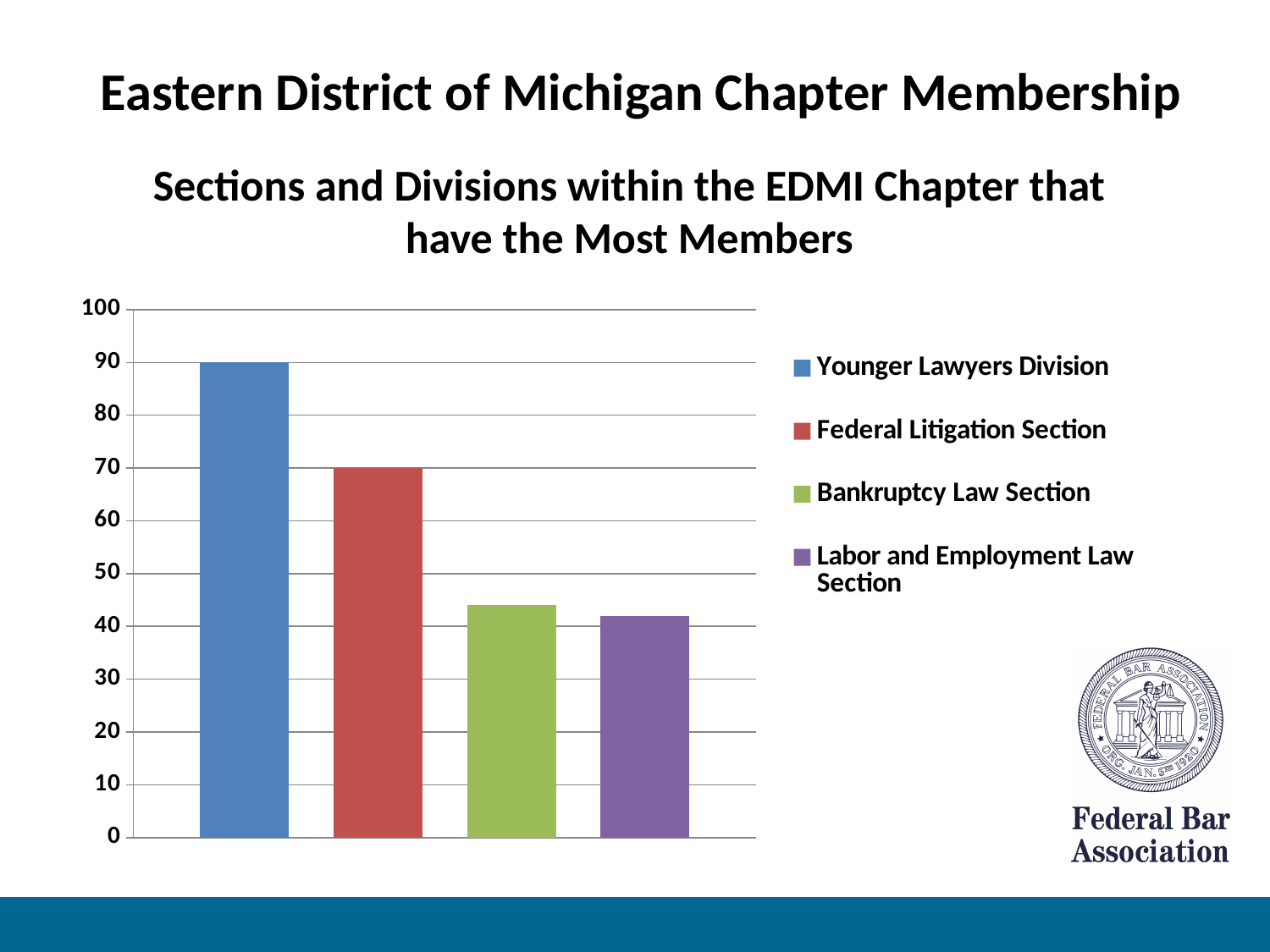
What is the value for the Federal Litigation Section? 70 What type of chart is shown on the slide? Bar chart Is the value for the Labor and Employment Law Section greater or less than 40? greater What colour is the bar for the Bankruptcy Law Section? Green How many bars are plotted in the chart? 4 What is the value for the Younger Lawyers Division? 90 Do the bar values rise or fall from left to right across the chart? fall Which is larger, the value for the Younger Lawyers Division or the Federal Litigation Section? Younger Lawyers Division Which section or division has the highest value? Younger Lawyers Division Is the value for the Bankruptcy Law Section greater or less than 50? less How many series does the legend list? 4 What is the difference between the Younger Lawyers Division and the Federal Litigation Section values? 20